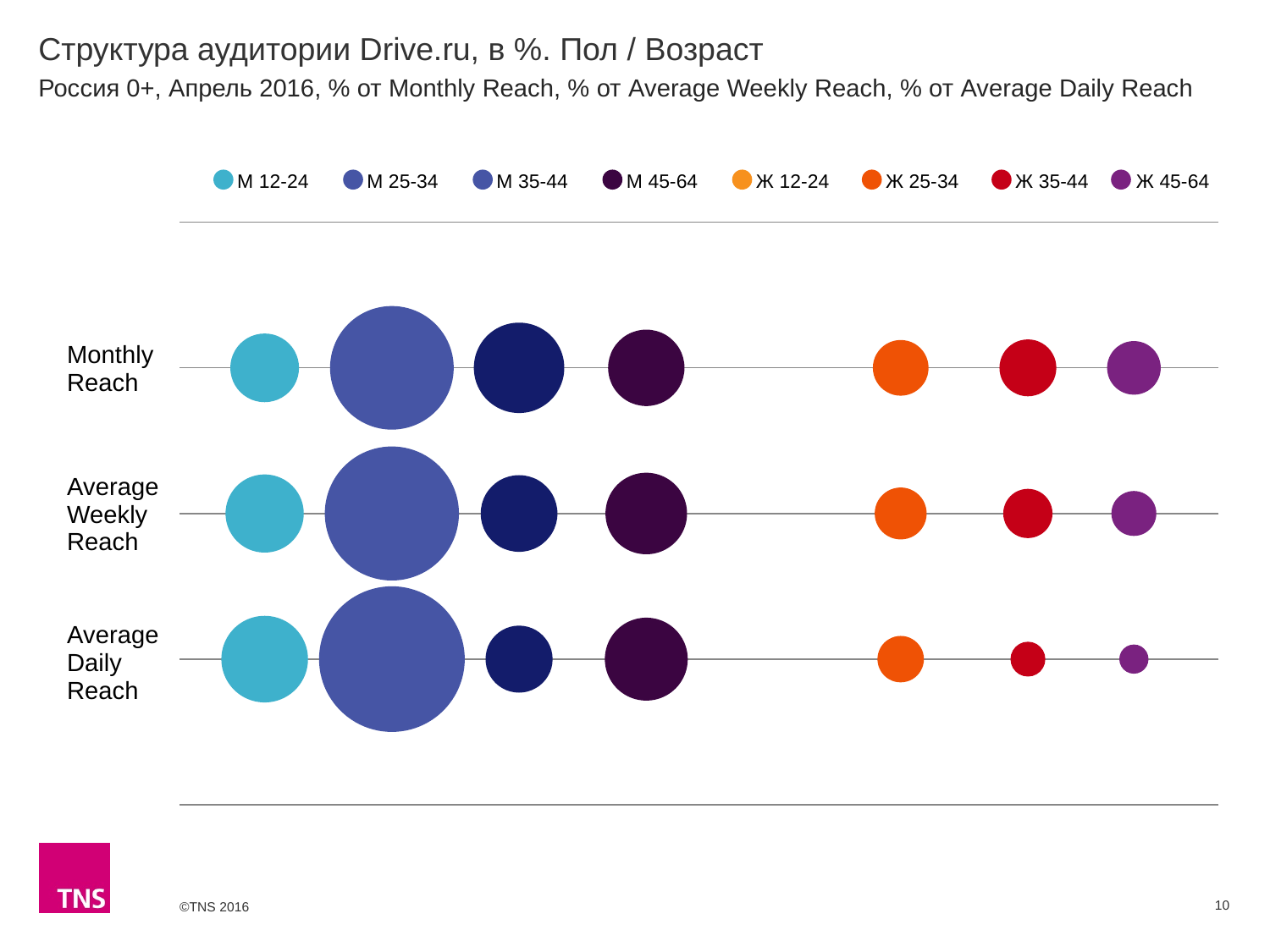
How many series does the legend list? 8 Which series has the largest bubble in the Average Daily Reach row? М 25-34 For the Ж 45-64 series, is the bubble larger in the Monthly Reach row or the Average Daily Reach row? Monthly Reach What colour is the М 12-24 series in the legend? Light blue What kind of chart is shown on the slide? Bubble chart Which series has the largest bubble in the Monthly Reach row? М 25-34 What is the title of the chart on the slide? Структура аудитории Drive.ru, в %. Пол / Возраст How many reach categories (rows) are plotted on the chart? 3 In the Average Daily Reach row, which bubble is larger: Ж 35-44 or Ж 45-64? Ж 35-44 Which series has the smallest bubble in the Average Daily Reach row? Ж 45-64 In the Average Daily Reach row, which bubble is larger: М 45-64 or М 35-44? М 45-64